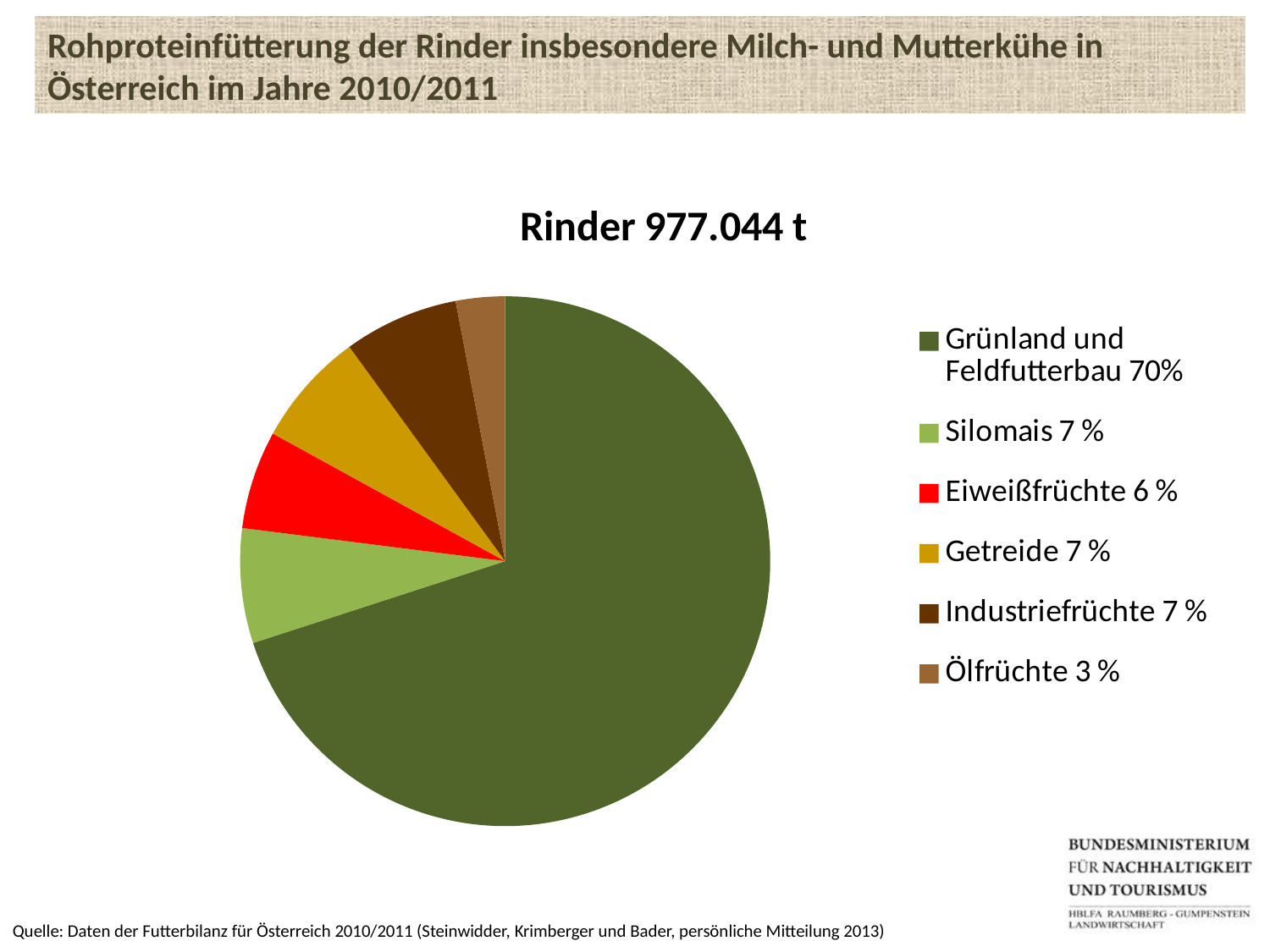
Which category has the smallest slice of the pie? Ölfrüchte What share of the pie does Ölfrüchte have? 3 % What share of the pie does Getreide have? 7 % Which is larger, the share for Eiweißfrüchte or the share for Ölfrüchte? Eiweißfrüchte What colour is the slice for Eiweißfrüchte? red What is the difference in percentage points between the share for Grünland und Feldfutterbau and the share for Silomais? 63 How many slices does the pie chart have? 6 Which category has the largest slice of the pie? Grünland und Feldfutterbau What is the title of the pie chart? Rinder 977.044 t What share of the pie does Eiweißfrüchte have? 6 % What kind of chart is shown on the slide? pie chart